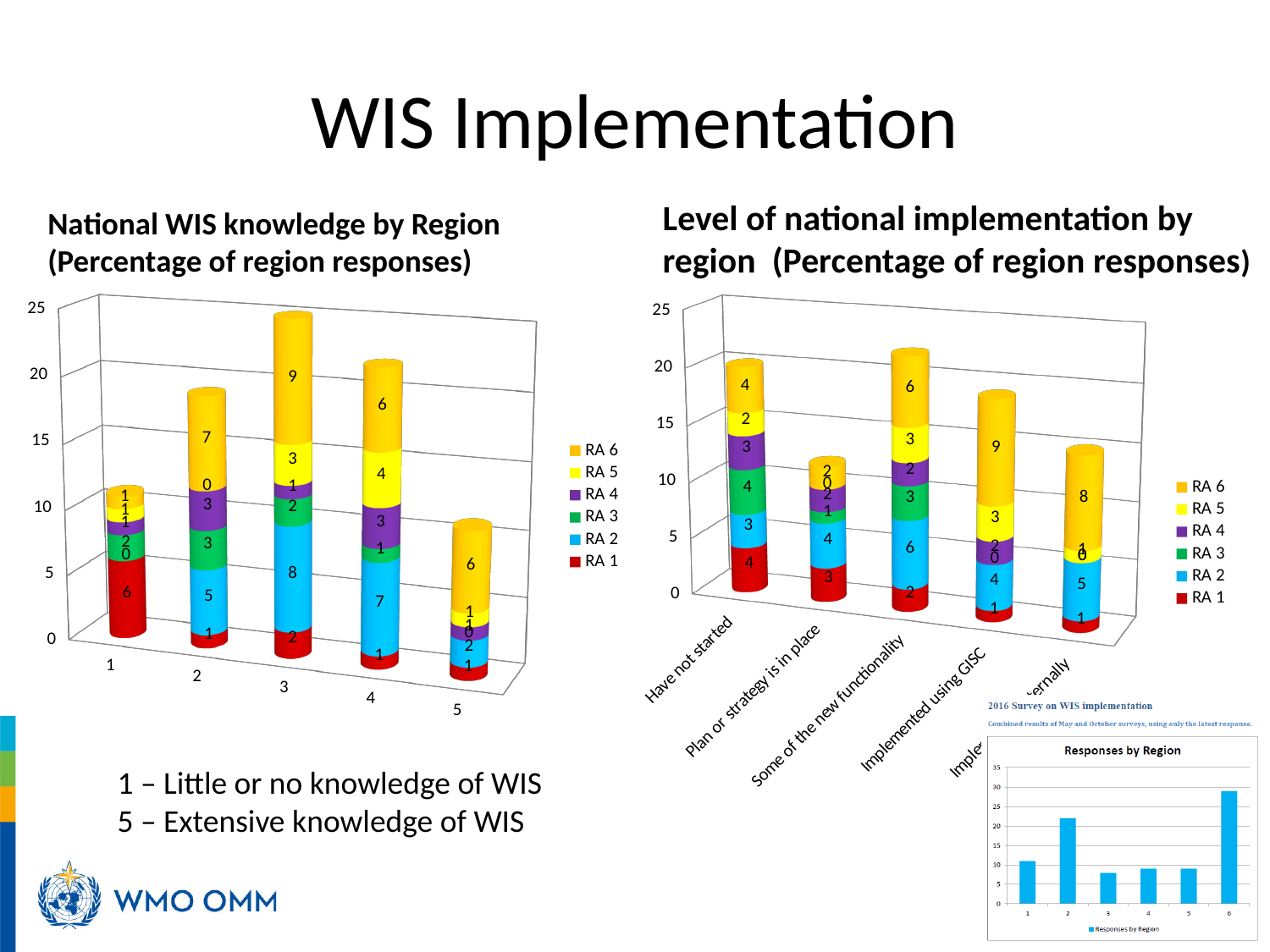
In the 'Level of national implementation by region' chart, what is the total of the stacked bar for 'Have not started'? 20 In the 'National WIS knowledge by Region' chart, what is the value for RA 6 at category 3? 9 In the 'Level of national implementation by region' chart, which is larger at 'Plan or strategy is in place': RA 2 or RA 1? RA 2 In the 'Level of national implementation by region' chart, what is the value for RA 2 at 'Some of the new functionality'? 6 In the 'National WIS knowledge by Region' chart, what is the value for RA 2 at category 4? 7 In the small 'Responses by Region' chart at the bottom right, is the value for region 6 greater or less than 25? greater In the 'Level of national implementation by region' chart, what is the value for RA 6 at 'Implemented using GISC'? 9 In the 'National WIS knowledge by Region' chart, what is the value for RA 1 at category 1? 6 In the 'National WIS knowledge by Region' chart, what is the difference between the RA 6 values at category 3 and category 2? 2 In the 'National WIS knowledge by Region' chart, how many series does the legend list? 6 In the 'Level of national implementation by region' chart, what is the value for RA 1 at 'Have not started'? 4 In the small 'Responses by Region' chart at the bottom right, which region has the highest value? 6